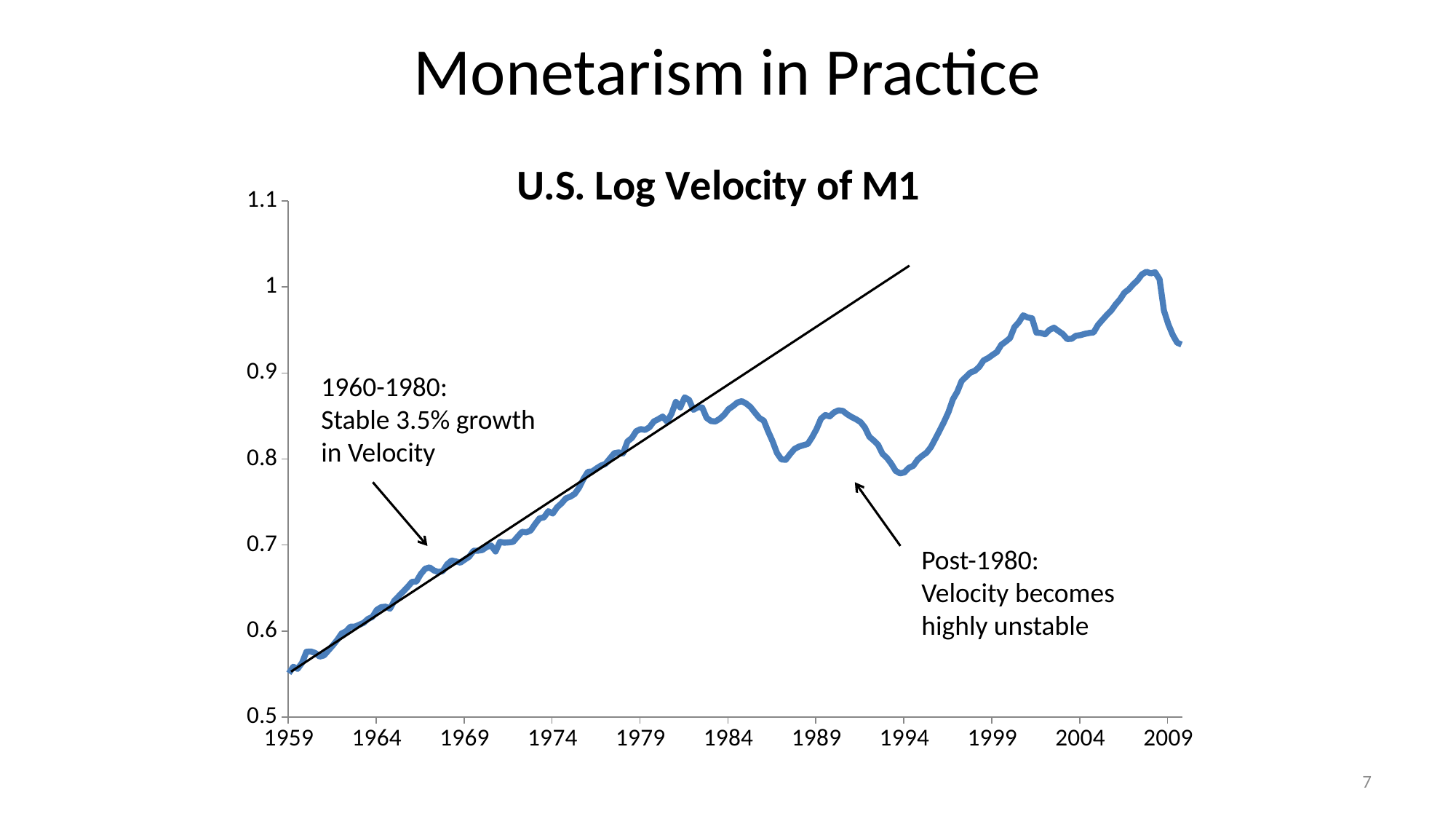
How many year labels are shown on the x axis? 11 Does the plotted velocity rise or fall between 1959 and 1979? rise Is the value for 1959 greater or less than 0.6? less What kind of chart is shown on the slide? line chart Is the value for 1984 greater or less than 0.8? greater Which is larger, the value for 1984 or the value for 1994? 1984 According to the annotation, what growth rate in velocity was stable during 1960-1980? 3.5% Of the years labelled on the x axis, which has the lowest plotted value? 1959 What is the title of the chart? U.S. Log Velocity of M1 Is the value for 2009 greater or less than 0.9? greater